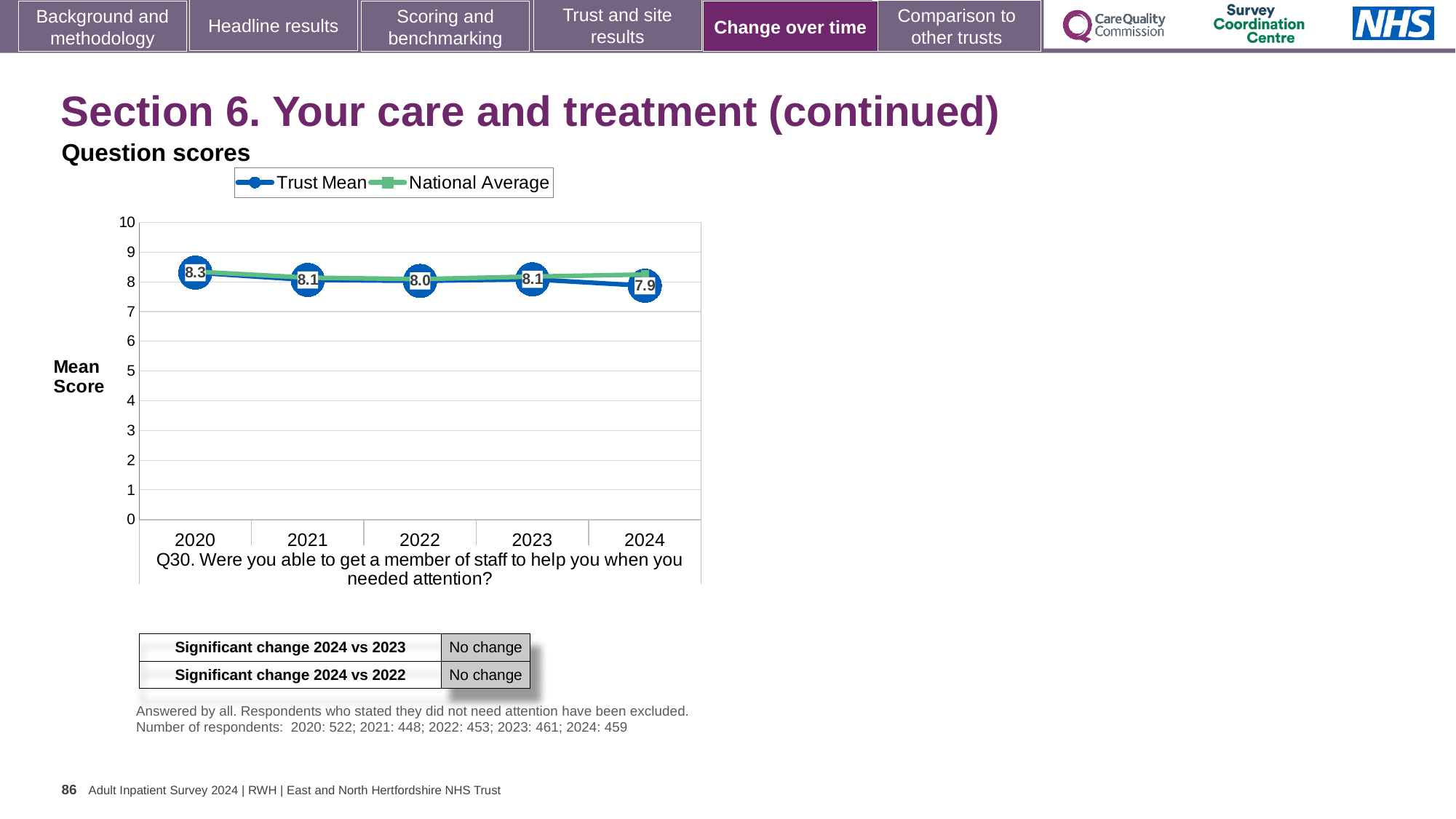
What is the Trust Mean score for 2024? 7.9 Which year has the larger Trust Mean score, 2020 or 2024? 2020 What kind of chart is shown on the slide? line chart Is the Trust Mean value for 2023 greater or less than 5? greater How many series does the legend list? 2 What is the Trust Mean score for 2020? 8.3 What is the difference between the Trust Mean score in 2020 and in 2024? 0.4 Does the Trust Mean score rise or fall from 2020 to 2024? fall What is the Trust Mean score for 2022? 8.0 How many years are plotted on the x axis? 5 In which year is the Trust Mean score lowest? 2024 In which year is the Trust Mean score highest? 2020